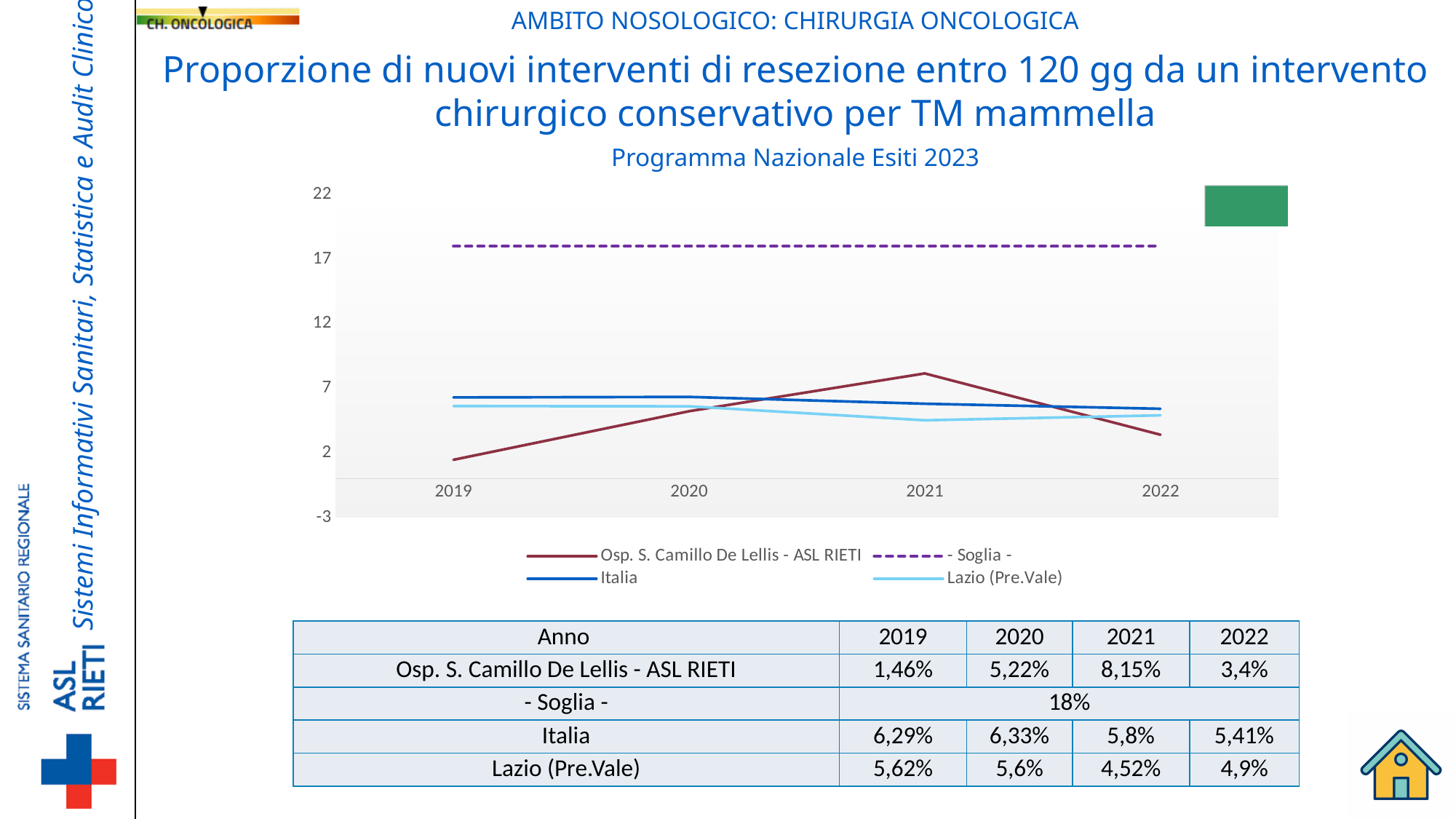
What is the value for Osp. S. Camillo De Lellis - ASL RIETI in 2021? 8,15% How many series does the chart legend list? 4 In which year is the value for Osp. S. Camillo De Lellis - ASL RIETI lowest? 2019 Does the Italia series rise or fall from 2020 to 2022? fall How many years are shown on the x axis of the chart? 4 What is the value for Lazio (Pre.Vale) in 2022? 4,9% In which year is the value for Osp. S. Camillo De Lellis - ASL RIETI highest? 2021 What is the value of the Soglia threshold line? 18% What is the value for Italia in 2020? 6,33% What kind of chart is shown on the slide? line chart What is the difference between the Osp. S. Camillo De Lellis - ASL RIETI value in 2021 and in 2022? 4,75% Which is larger in 2019: the value for Italia or the value for Osp. S. Camillo De Lellis - ASL RIETI? Italia